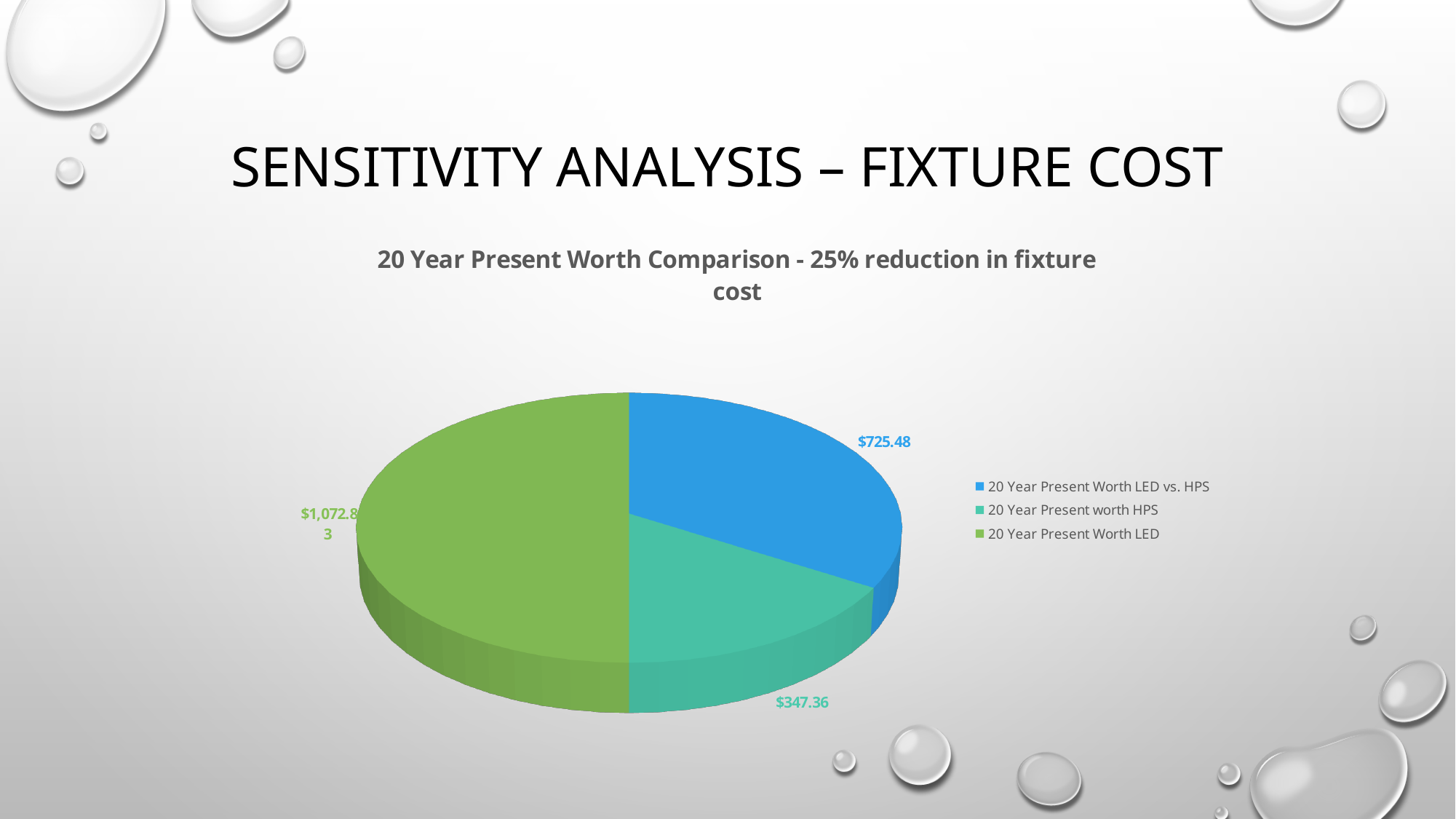
Which is larger, the 20 Year Present Worth LED vs. HPS value or the 20 Year Present worth HPS value? 20 Year Present Worth LED vs. HPS What is the difference between the 20 Year Present Worth LED value and the 20 Year Present Worth LED vs. HPS value? $347.35 Which slice has the smallest value? 20 Year Present worth HPS What is the value of the 20 Year Present Worth LED vs. HPS slice? $725.48 How many entries does the legend list? 3 What is the value of the 20 Year Present worth HPS slice? $347.36 Which slice has the largest value? 20 Year Present Worth LED What is the difference between the 20 Year Present Worth LED vs. HPS value and the 20 Year Present worth HPS value? $378.12 What is the total of all three slice values? $2,145.67 What is the value of the 20 Year Present Worth LED slice? $1,072.83 What kind of chart is shown on the slide? Pie chart How many slices does the pie chart have? 3